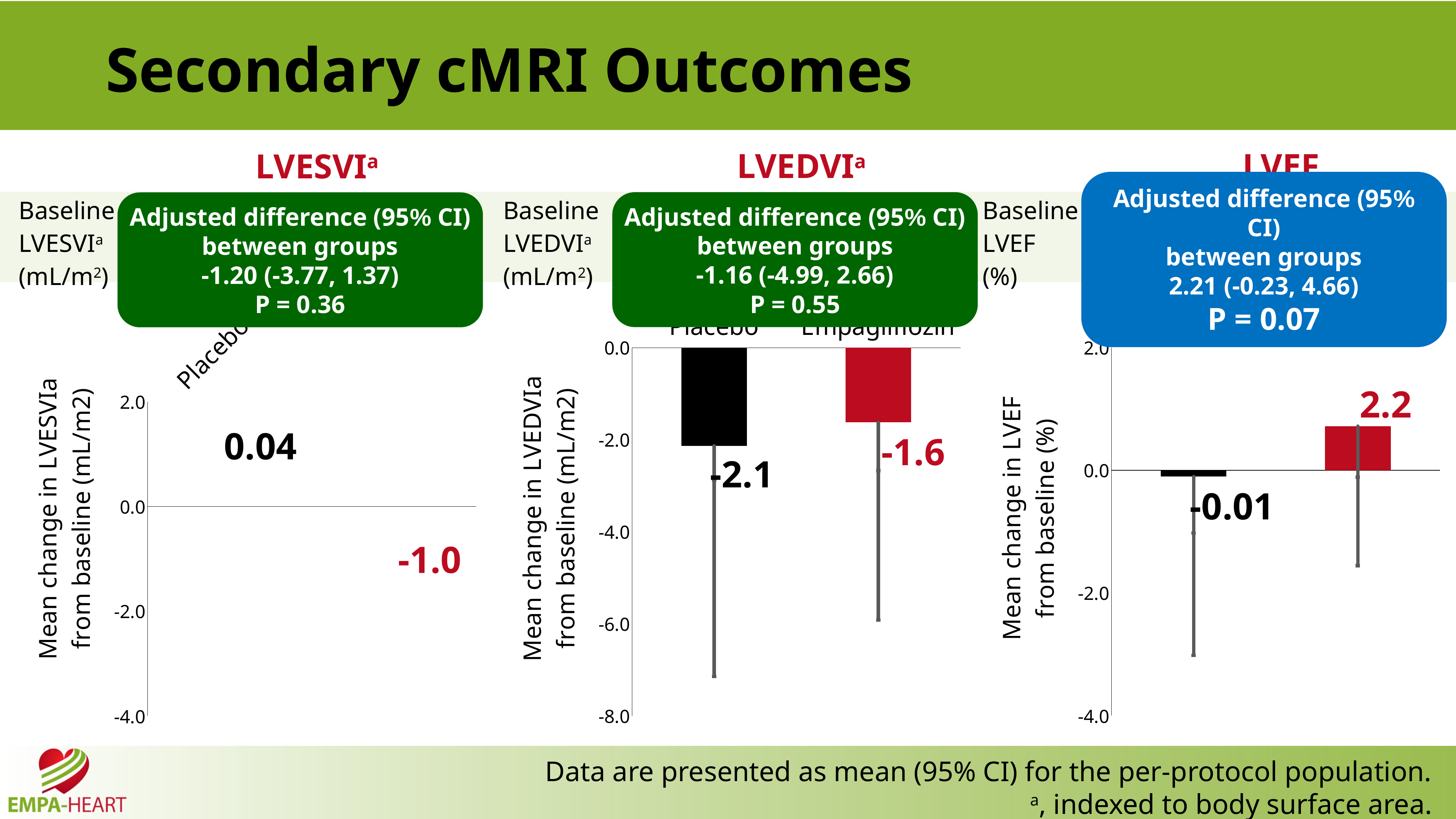
What is the y-axis label of the LVEF chart? Mean change in LVEF from baseline (%) What type of chart is the LVEDVI chart? bar chart In the LVEDVI chart, what is the mean change from baseline for the Placebo (black) bar? -2.1 In the LVEDVI chart, what is the difference between the black bar value (-2.1) and the red bar value (-1.6)? 0.5 In the LVESVI chart, what is the red-labelled mean change from baseline value? -1.0 In the LVEF chart, what value is labelled on the red bar? 2.2 In the LVESVI chart, what is the mean change from baseline labelled for Placebo? 0.04 In the LVEDVI chart, which bar shows the larger decrease from baseline, the black bar or the red bar? the black bar In the LVEF chart, what value is labelled on the black bar? -0.01 In the LVEDVI chart, what is the mean change from baseline for the red (Empagliflozin) bar? -1.6 How many bars are plotted in the LVEDVI chart? 2